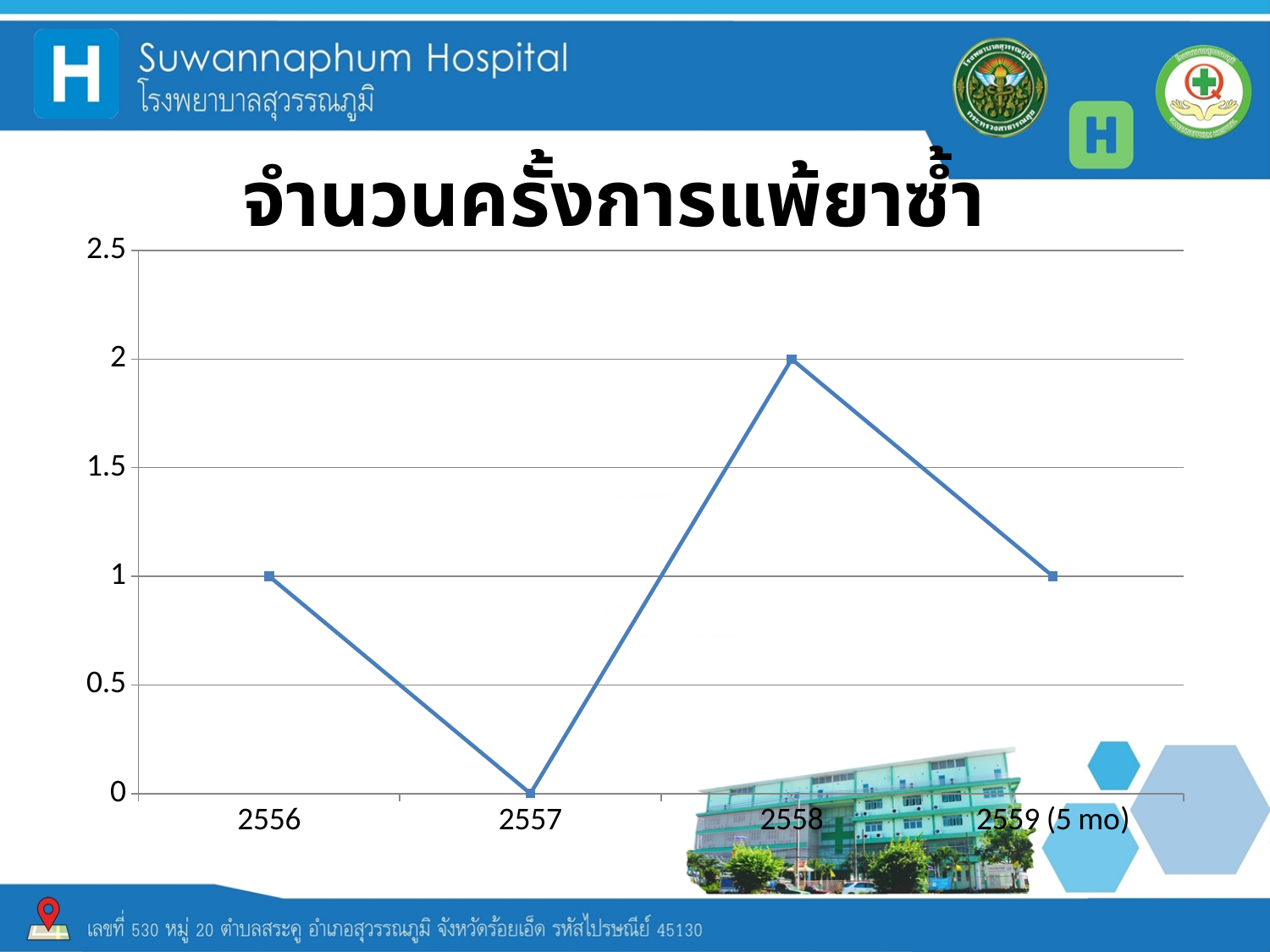
Does the value rise or fall from 2558 to 2559 (5 mo)? fall What is the title of the chart? จำนวนครั้งการแพ้ยาซ้ำ Which is larger, the value for 2556 or the value for 2558? 2558 How many data points are plotted on the line? 4 What is the value for 2559 (5 mo)? 1 What is the value for 2556? 1 Which year has the lowest value? 2557 What is the value for 2558? 2 Which year has the highest value? 2558 What is the difference between the values for 2558 and 2557? 2 What kind of chart is shown on the slide? line chart What is the value for 2557? 0